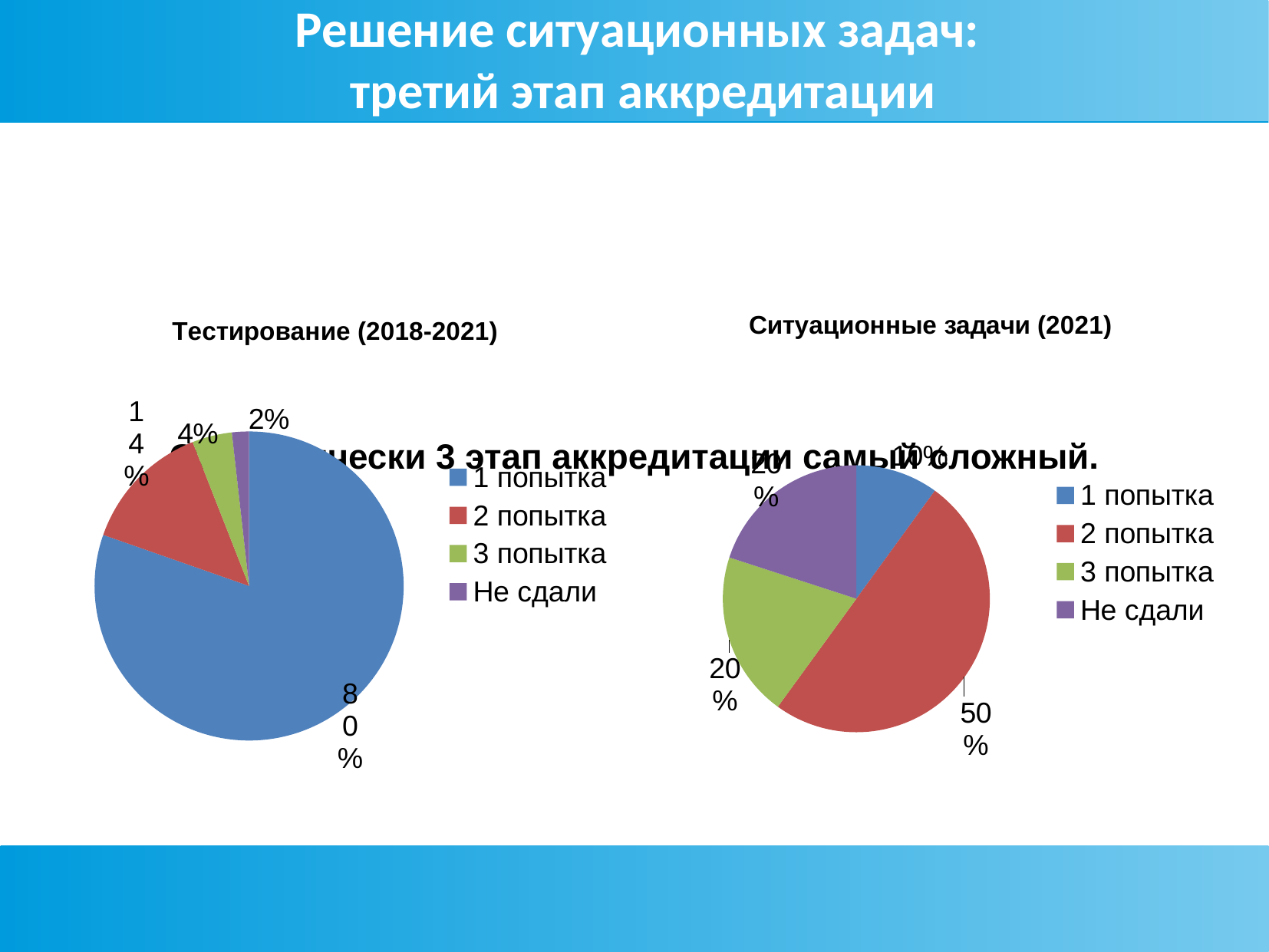
In the chart titled "Ситуационные задачи (2021)", what share of the pie is "2 попытка"? 50% What kind of chart is the chart titled "Тестирование (2018-2021)"? Pie chart In the chart titled "Тестирование (2018-2021)", which category has the smallest slice? Не сдали In the chart titled "Тестирование (2018-2021)", what colour is the slice for "3 попытка"? Green In the chart titled "Ситуационные задачи (2021)", what share of the pie is "3 попытка"? 20% In the chart titled "Тестирование (2018-2021)", what share of the pie is "Не сдали"? 2% In the chart titled "Тестирование (2018-2021)", what is the difference between the shares for "2 попытка" and "3 попытка"? 10% In the chart titled "Ситуационные задачи (2021)", which is larger: the slice for "2 попытка" or the slice for "1 попытка"? 2 попытка In the chart titled "Тестирование (2018-2021)", what share of the pie is "1 попытка"? 80% In the chart titled "Ситуационные задачи (2021)", which category has the largest slice? 2 попытка How many categories does the legend of the chart titled "Ситуационные задачи (2021)" list? 4 In the chart titled "Тестирование (2018-2021)", what share of the pie is "2 попытка"? 14%